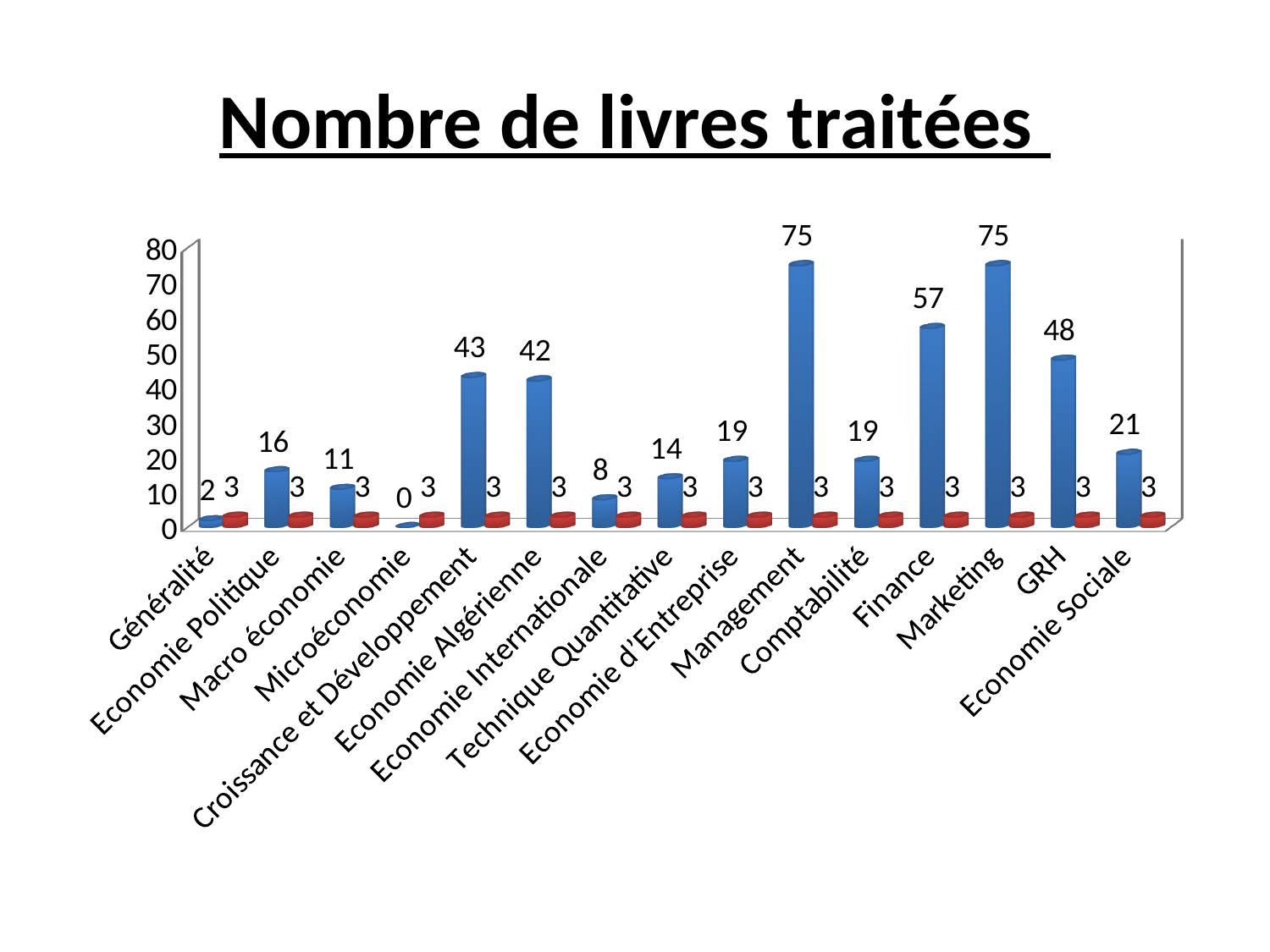
What is the title of the chart? Nombre de livres traitées Which category has the lowest blue bar value? Microéconomie What is the value of the red bar for Comptabilité? 3 What is the difference between the blue bar values for Finance and GRH? 9 What is the value of the blue bar for Croissance et Développement? 43 What is the difference between the blue bar values for Economie Sociale and Economie Politique? 5 What is the value of the blue bar for Finance? 57 What is the value of the blue bar for GRH? 48 What kind of chart is shown on the slide? Bar chart How many categories are shown on the x axis? 15 What is the highest value shown by a blue bar? 75 Which has a larger blue bar value, Economie Algérienne or Economie Internationale? Economie Algérienne